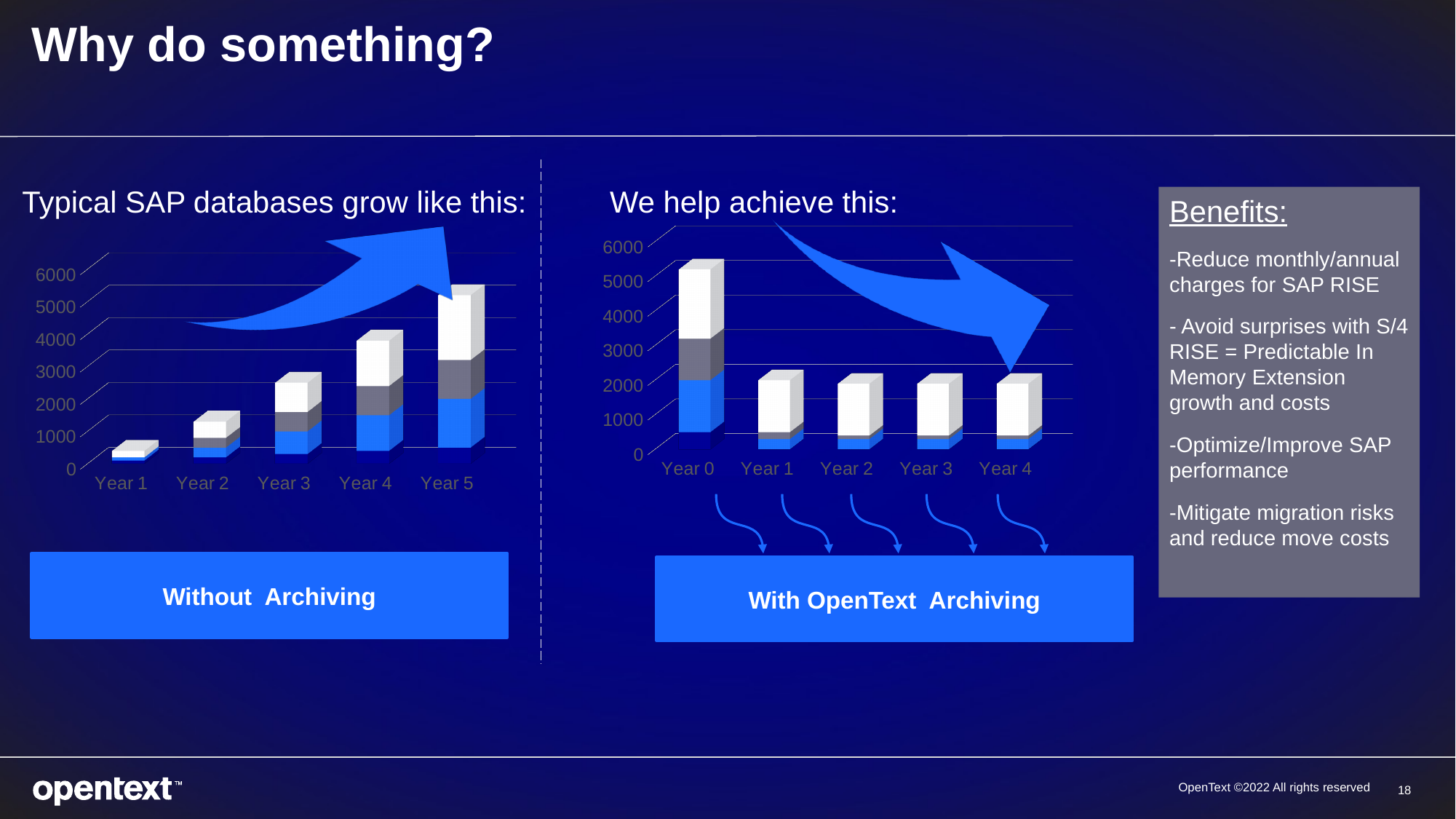
How many year categories are shown on the x axis of the left chart ("Typical SAP databases grow like this:")? 5 In the right chart ("We help achieve this:"), which year has the tallest bar? Year 0 How many year categories are shown on the x axis of the right chart ("We help achieve this:")? 5 What kind of chart is the left chart titled "Typical SAP databases grow like this:"? bar chart In the left chart ("Typical SAP databases grow like this:"), which year has the shortest bar? Year 1 In the right chart ("We help achieve this:"), is the total for Year 3 greater or less than 3000? less What label appears in the box below the right chart ("We help achieve this:")? With OpenText Archiving In the left chart ("Typical SAP databases grow like this:"), is the total for Year 1 greater or less than 1000? less In the left chart ("Typical SAP databases grow like this:"), is the total for Year 5 greater or less than 4000? greater In the left chart ("Typical SAP databases grow like this:"), which year has the tallest bar? Year 5 In the left chart ("Typical SAP databases grow like this:"), do the bar heights rise or fall from Year 1 to Year 5? rise